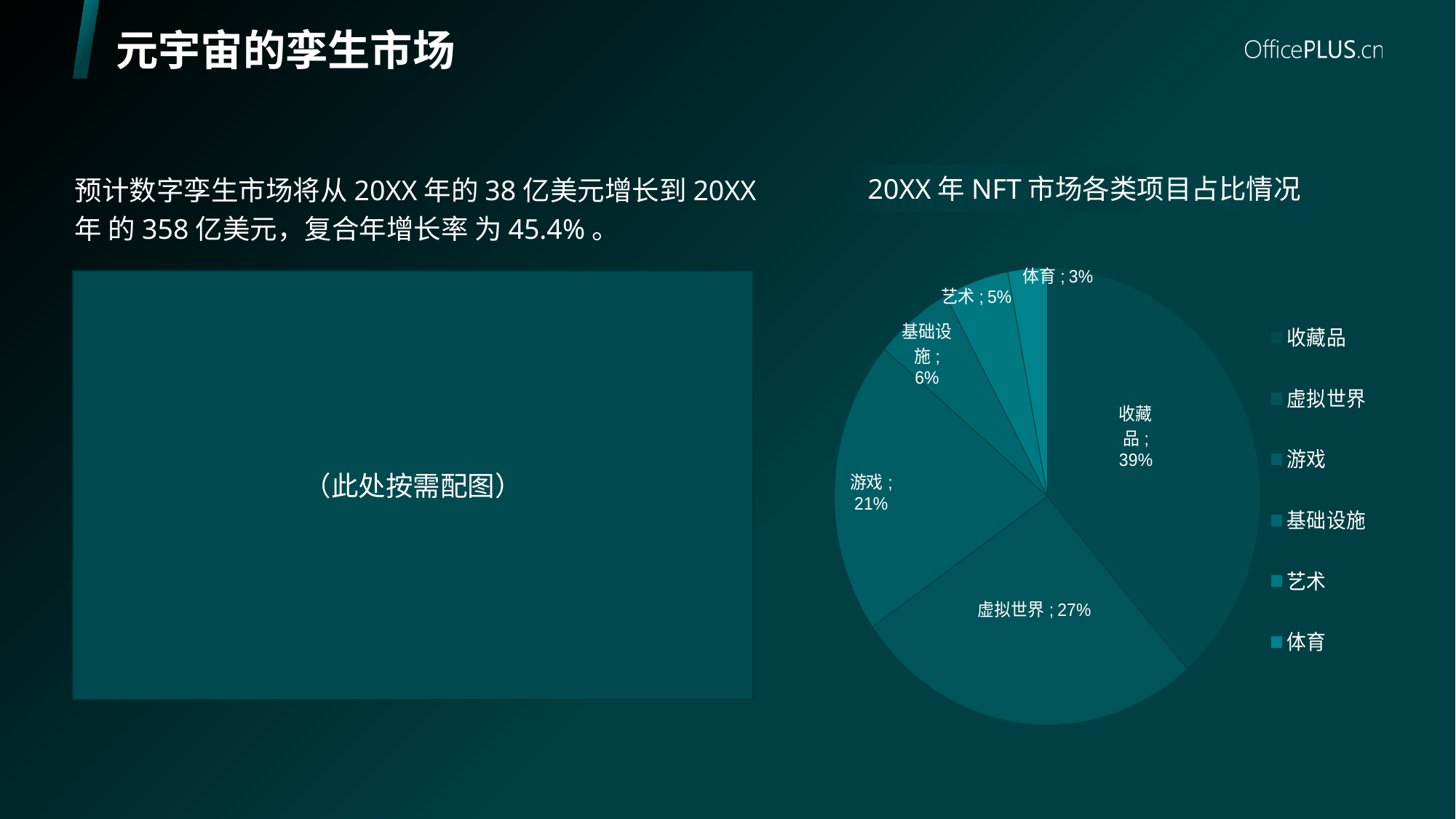
What share of the pie does 收藏品 hold? 39% What is the title of the chart? 20XX 年 NFT 市场各类项目占比情况 What is the difference between the shares of 艺术 and 体育? 2% Which category has the smallest slice of the pie? 体育 What kind of chart is shown on the slide? Pie chart Which is larger, the share of 游戏 or the share of 虚拟世界? 虚拟世界 What is the value shown for 游戏? 21% How many categories are shown in the pie chart? 6 What is the value shown for 基础设施? 6% What is the value shown for 虚拟世界? 27% Which category has the largest slice of the pie? 收藏品 What is the difference between the shares of 收藏品 and 虚拟世界? 12%